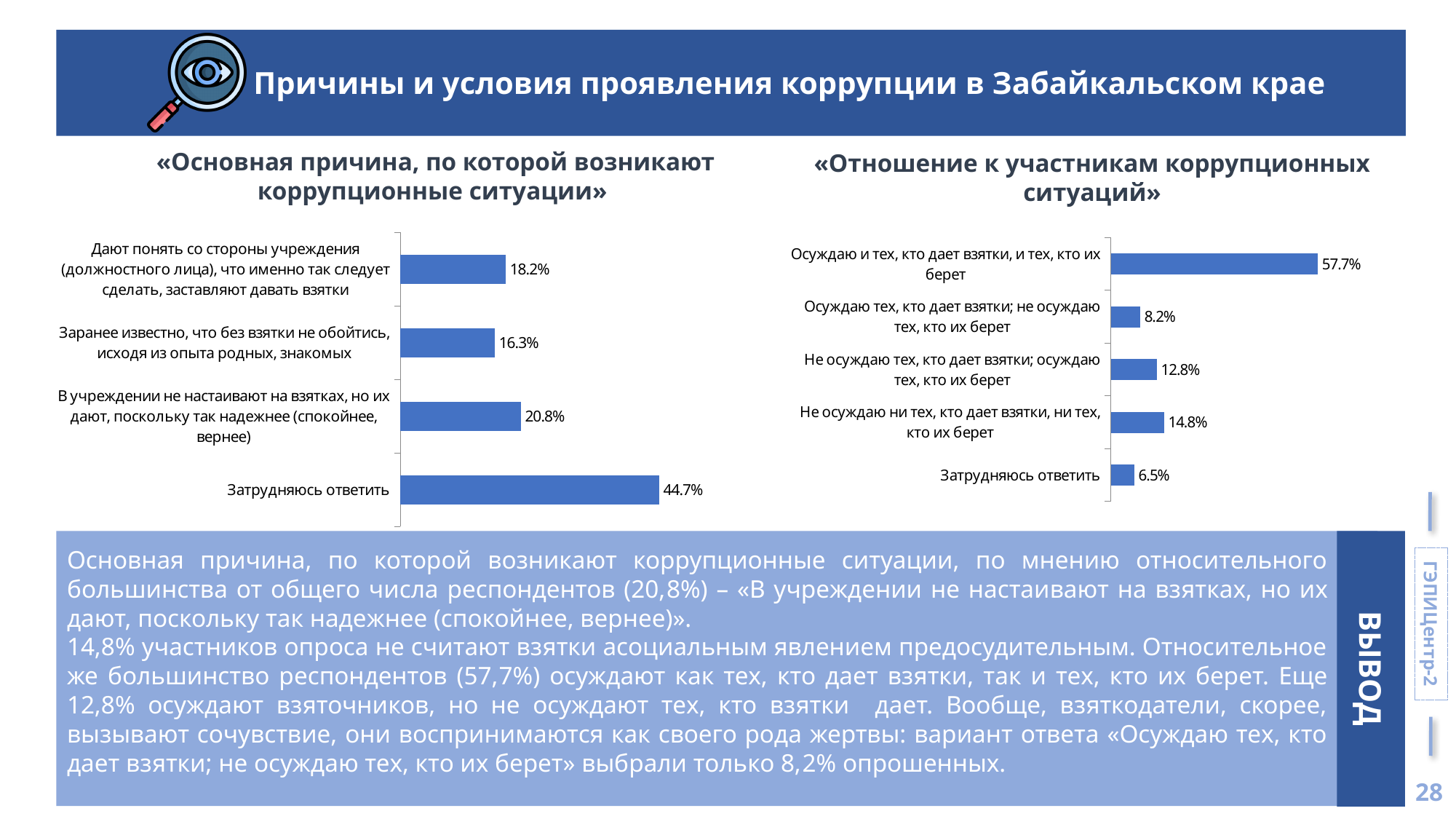
На диаграмме «Отношение к участникам коррупционных ситуаций» какое значение у варианта «Не осуждаю ни тех, кто дает взятки, ни тех, кто их берет»? 14.8% На диаграмме «Отношение к участникам коррупционных ситуаций» какой вариант ответа имеет наименьшее значение? Затрудняюсь ответить На диаграмме «Отношение к участникам коррупционных ситуаций» что больше: «Осуждаю тех, кто дает взятки; не осуждаю тех, кто их берет» или «Не осуждаю тех, кто дает взятки; осуждаю тех, кто их берет»? Не осуждаю тех, кто дает взятки; осуждаю тех, кто их берет Сколько категорий показано на диаграмме «Отношение к участникам коррупционных ситуаций»? 5 На диаграмме «Отношение к участникам коррупционных ситуаций» какое значение у варианта «Осуждаю и тех, кто дает взятки, и тех, кто их берет»? 57.7% Сколько категорий показано на диаграмме «Основная причина, по которой возникают коррупционные ситуации»? 4 На диаграмме «Основная причина, по которой возникают коррупционные ситуации» какое значение у варианта «Заранее известно, что без взятки не обойтись, исходя из опыта родных, знакомых»? 16.3% На диаграмме «Основная причина, по которой возникают коррупционные ситуации» на сколько процентных пунктов значение «В учреждении не настаивают на взятках, но их дают, поскольку так надежнее (спокойнее, вернее)» больше значения «Дают понять со стороны учреждения (должностного лица), что именно так следует сделать, заставляют давать взятки»? 2.6 На диаграмме «Основная причина, по которой возникают коррупционные ситуации» какое значение у варианта «Затрудняюсь ответить»? 44.7% На диаграмме «Основная причина, по которой возникают коррупционные ситуации» какой вариант ответа имеет наименьшее значение? Заранее известно, что без взятки не обойтись, исходя из опыта родных, знакомых На диаграмме «Отношение к участникам коррупционных ситуаций» на сколько процентных пунктов значение «Осуждаю и тех, кто дает взятки, и тех, кто их берет» больше значения «Затрудняюсь ответить»? 51.2 Какого типа диаграмма «Отношение к участникам коррупционных ситуаций»? Столбчатая (горизонтальная) диаграмма